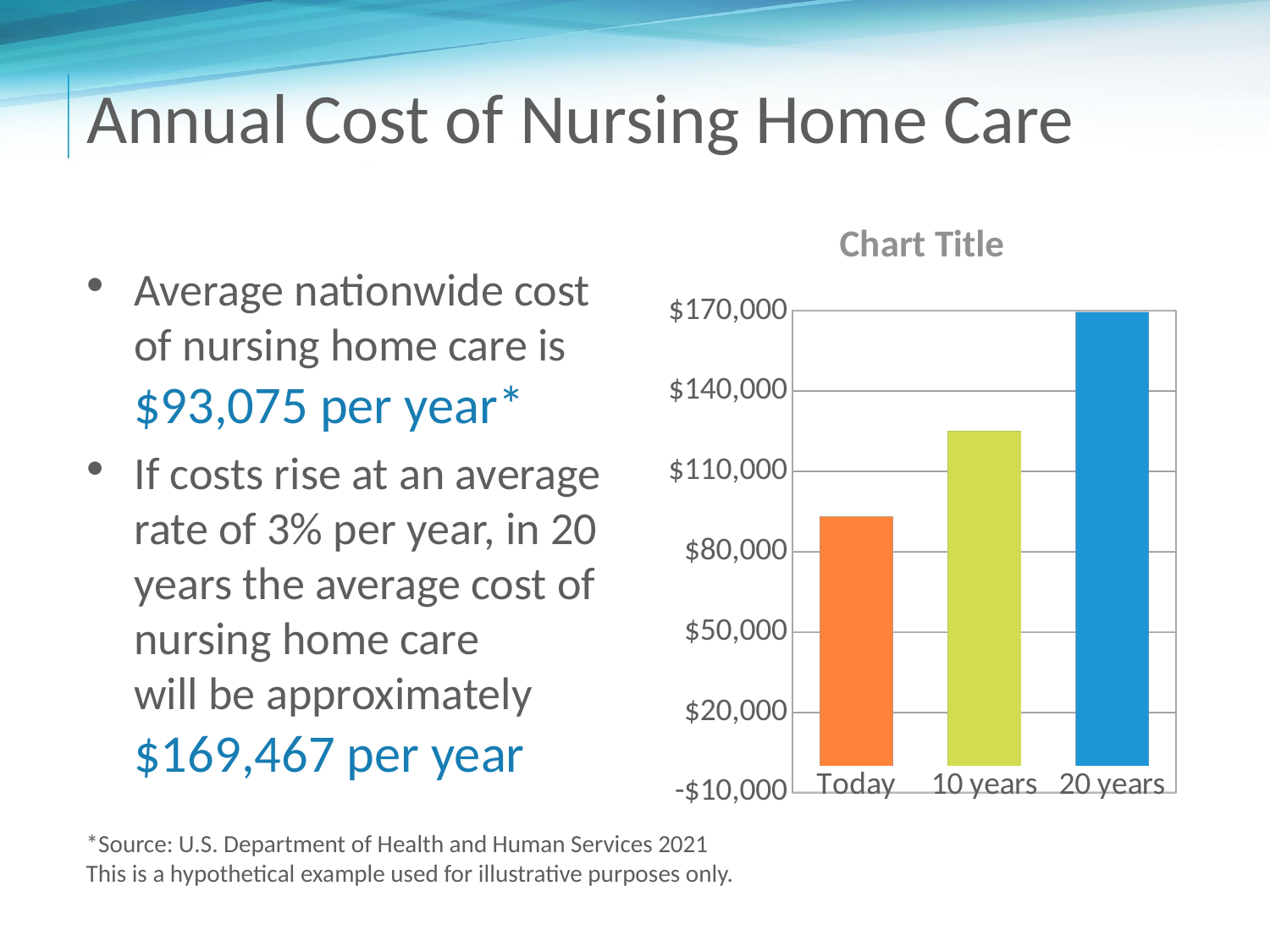
What kind of chart is shown on the slide? bar chart Which category has the highest bar in the chart? 20 years Which category has the lowest bar in the chart? Today Is the value for Today greater or less than $80,000? greater Is the value for Today greater or less than $110,000? less How many bars does the chart have? 3 Which is larger, the value for 10 years or the value for 20 years? 20 years Is the value for 10 years greater or less than $140,000? less What colour is the bar for 20 years? blue Do the values rise or fall from Today to 20 years along the x axis? rise